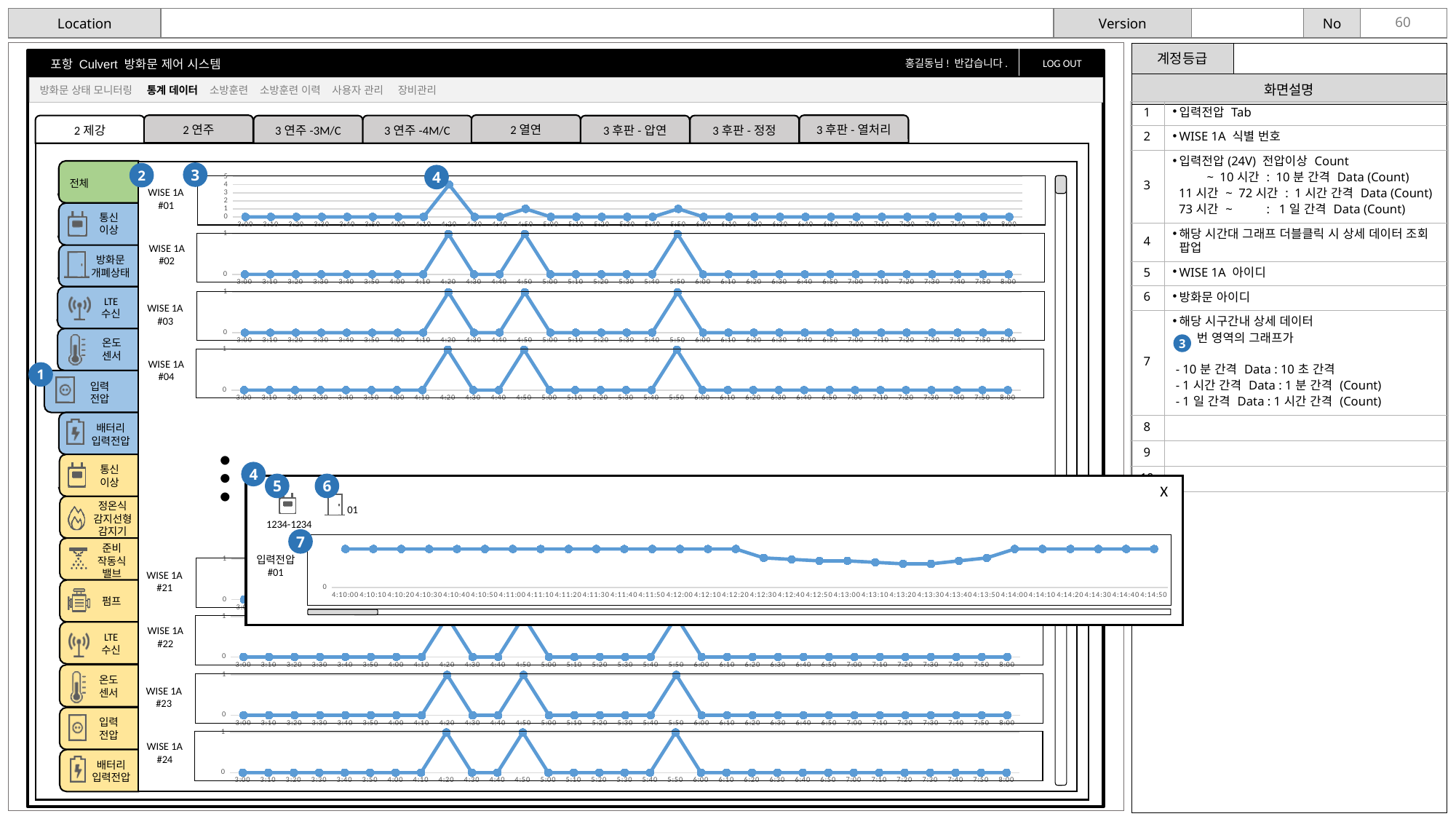
What is the last time label on the x axis of the WISE 1A #22 chart? 8:00 In the WISE 1A #01 chart, which time has the highest value? 4:20 In the WISE 1A #02 chart, what is the value at 4:20? 1 What kind of chart is used for the WISE 1A #02 panel? line chart In the WISE 1A #03 chart, what is the value at 3:00? 0 In the popup chart labelled 입력전압 #01, does the line dip or rise between 4:12:20 and 4:13:30? dip In the popup chart labelled 입력전압 #01, what is the first x-axis label? 4:10:00 In the WISE 1A #23 chart, which is larger, the value at 4:20 or the value at 5:00? 4:20 In the WISE 1A #04 chart, at which three times does the line reach 1? 4:20, 4:50, 5:50 In the WISE 1A #01 chart, is the value at 4:20 greater or less than 3? greater In the WISE 1A #01 chart, is the value at 4:50 greater or less than 3? less What is the first time label on the x axis of the WISE 1A #24 chart? 3:00